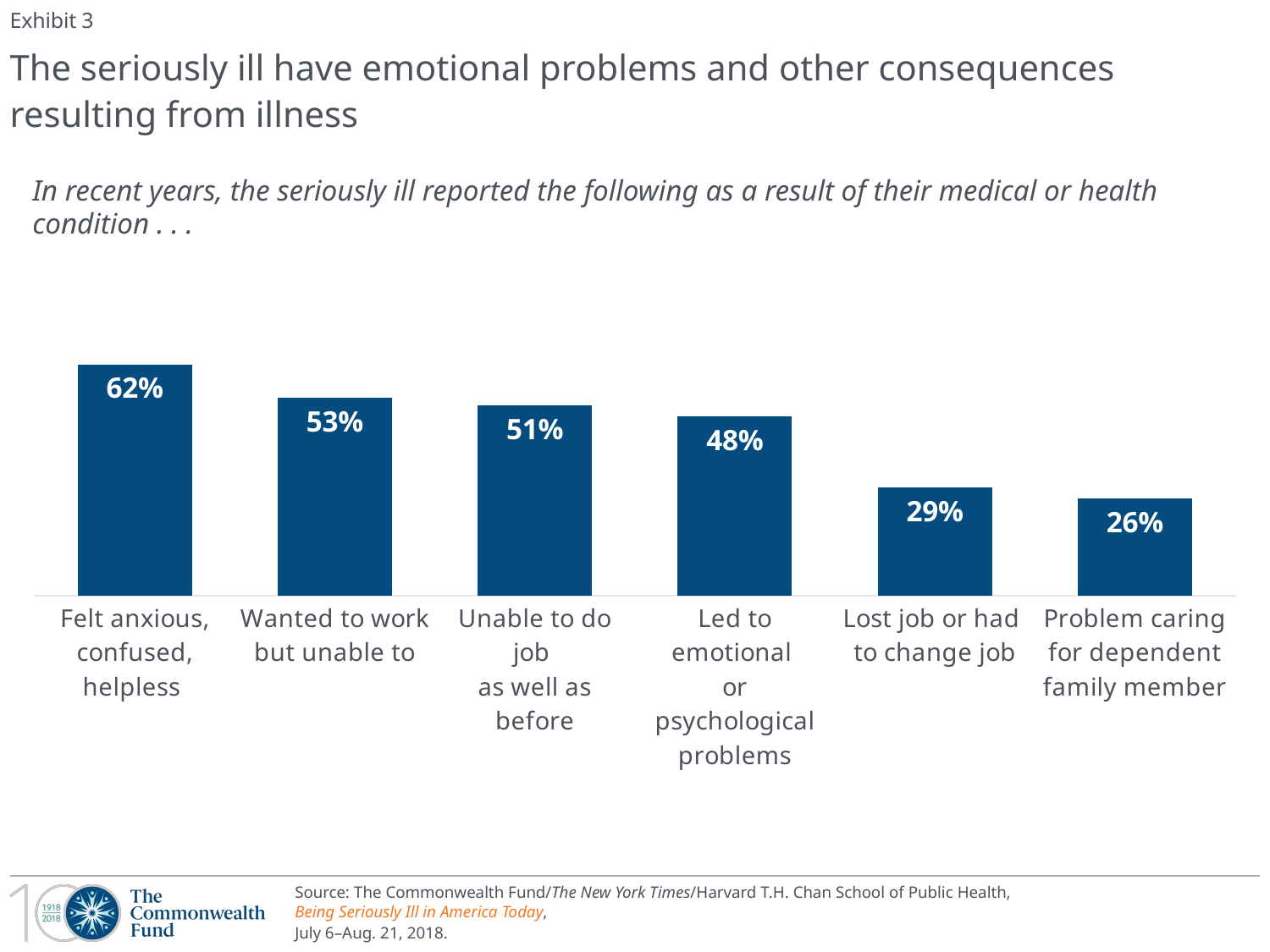
What percentage reported losing a job or having to change job? 29% What is the difference in percentage points between 'Wanted to work but unable to' and 'Unable to do job as well as before'? 2 percentage points What percentage reported a problem caring for a dependent family member? 26% How many consequences are shown in the chart? 6 Which was reported by more people: 'Led to emotional or psychological problems' or 'Lost job or had to change job'? Led to emotional or psychological problems What percentage reported that their condition led to emotional or psychological problems? 48% What is the difference in percentage points between 'Felt anxious, confused, helpless' and 'Lost job or had to change job'? 33 percentage points Which consequence was reported by the largest share of the seriously ill? Felt anxious, confused, helpless What percentage of the seriously ill reported feeling anxious, confused, or helpless? 62% What type of chart is shown on the slide? Bar chart Do the values rise or fall moving from left to right across the chart? Fall Which consequence was reported by the smallest share of the seriously ill? Problem caring for dependent family member